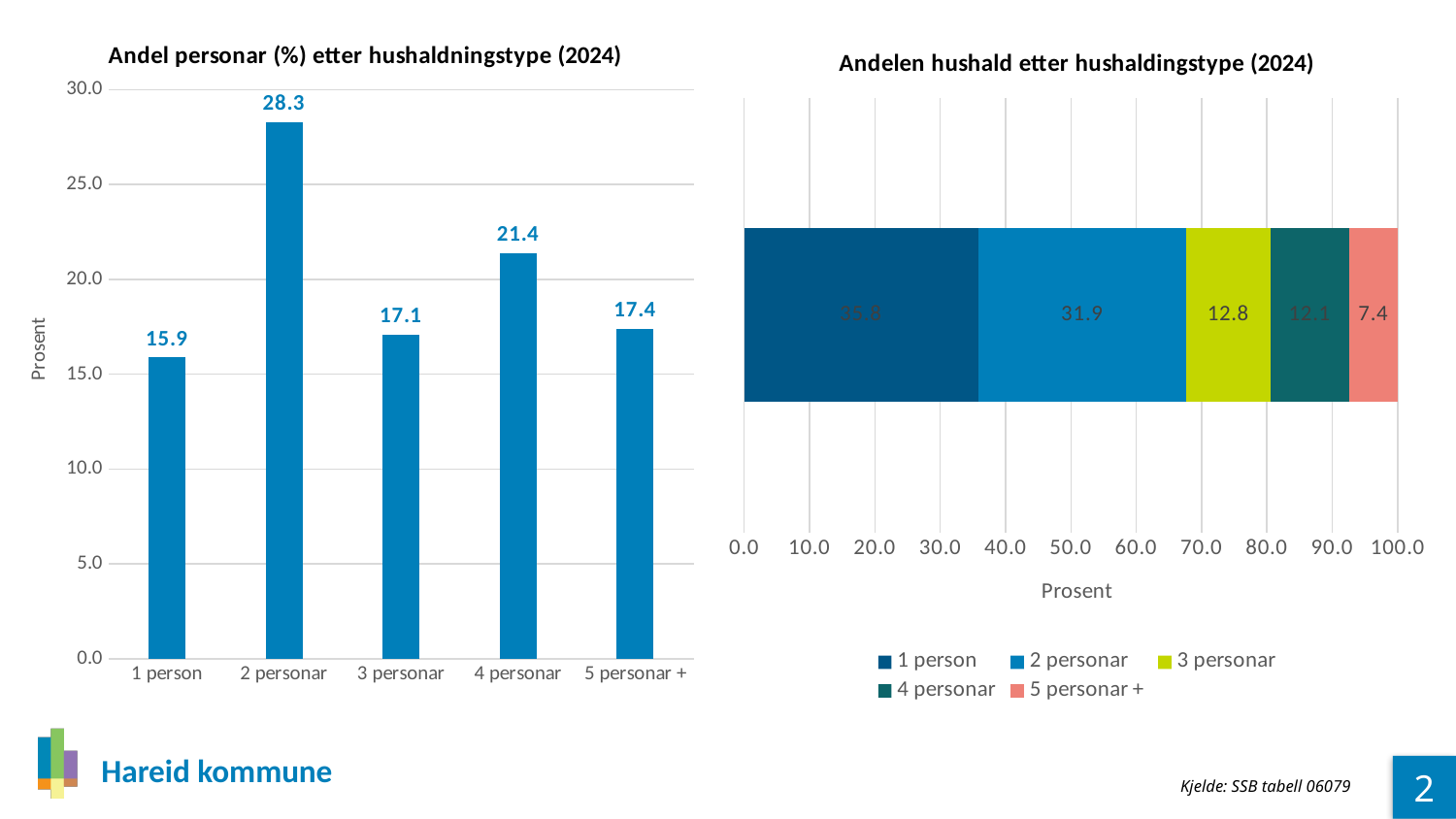
In the left chart 'Andel personar (%) etter hushaldningstype (2024)', which household type has the lowest value? 1 person In the right chart 'Andelen hushald etter hushaldingstype (2024)', what is the value for 2 personar? 31.9 What kind of chart is the left chart 'Andel personar (%) etter hushaldningstype (2024)'? Bar chart In the left chart 'Andel personar (%) etter hushaldningstype (2024)', what is the difference between the values for 2 personar and 1 person? 12.4 How many series does the legend of the right chart 'Andelen hushald etter hushaldingstype (2024)' list? 5 In the left chart 'Andel personar (%) etter hushaldningstype (2024)', how many household types are shown on the x axis? 5 In the left chart 'Andel personar (%) etter hushaldningstype (2024)', which household type has the highest value? 2 personar In the left chart 'Andel personar (%) etter hushaldningstype (2024)', what is the value for 2 personar? 28.3 In the left chart 'Andel personar (%) etter hushaldningstype (2024)', which is larger, the value for 4 personar or the value for 3 personar? 4 personar In the right chart 'Andelen hushald etter hushaldingstype (2024)', what is the value for 5 personar +? 7.4 In the left chart 'Andel personar (%) etter hushaldningstype (2024)', what is the value for 1 person? 15.9 In the left chart 'Andel personar (%) etter hushaldningstype (2024)', what is the value for 4 personar? 21.4